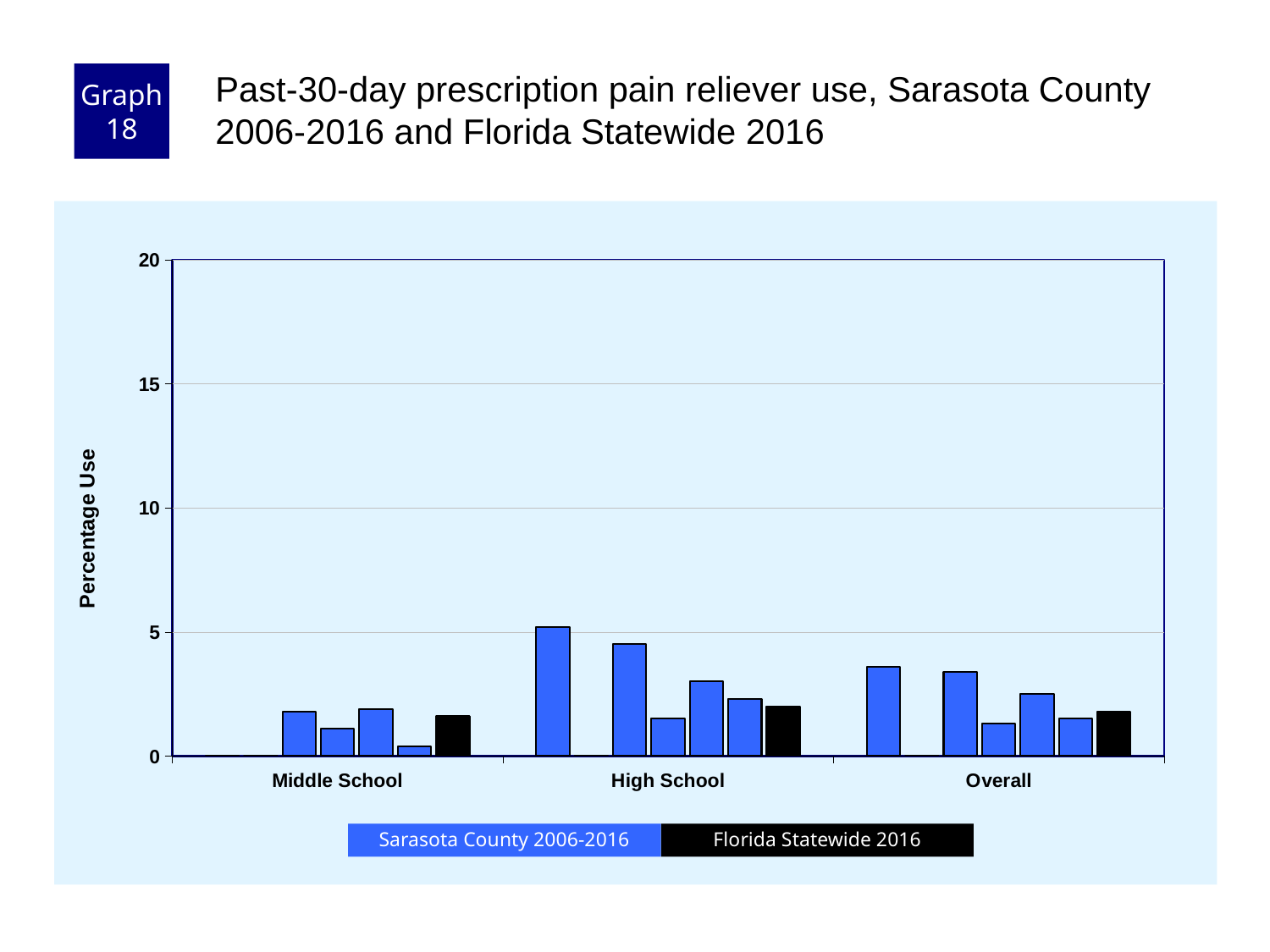
How many series does the legend list? 2 Are all the Middle School bars greater or less than 5? less What is the label on the y axis? Percentage Use Is the Florida Statewide 2016 bar for High School larger or smaller than the Florida Statewide 2016 bar for Middle School? larger What is the highest value shown on the y axis? 20 Which category contains the tallest bar in the chart? High School Is the tallest bar in the Overall category greater or less than 5? less Is the Florida Statewide 2016 value for High School greater or less than 5? less What kind of chart is shown on the slide? bar chart Which category has the lowest bars overall? Middle School How many categories are shown on the x axis? 3